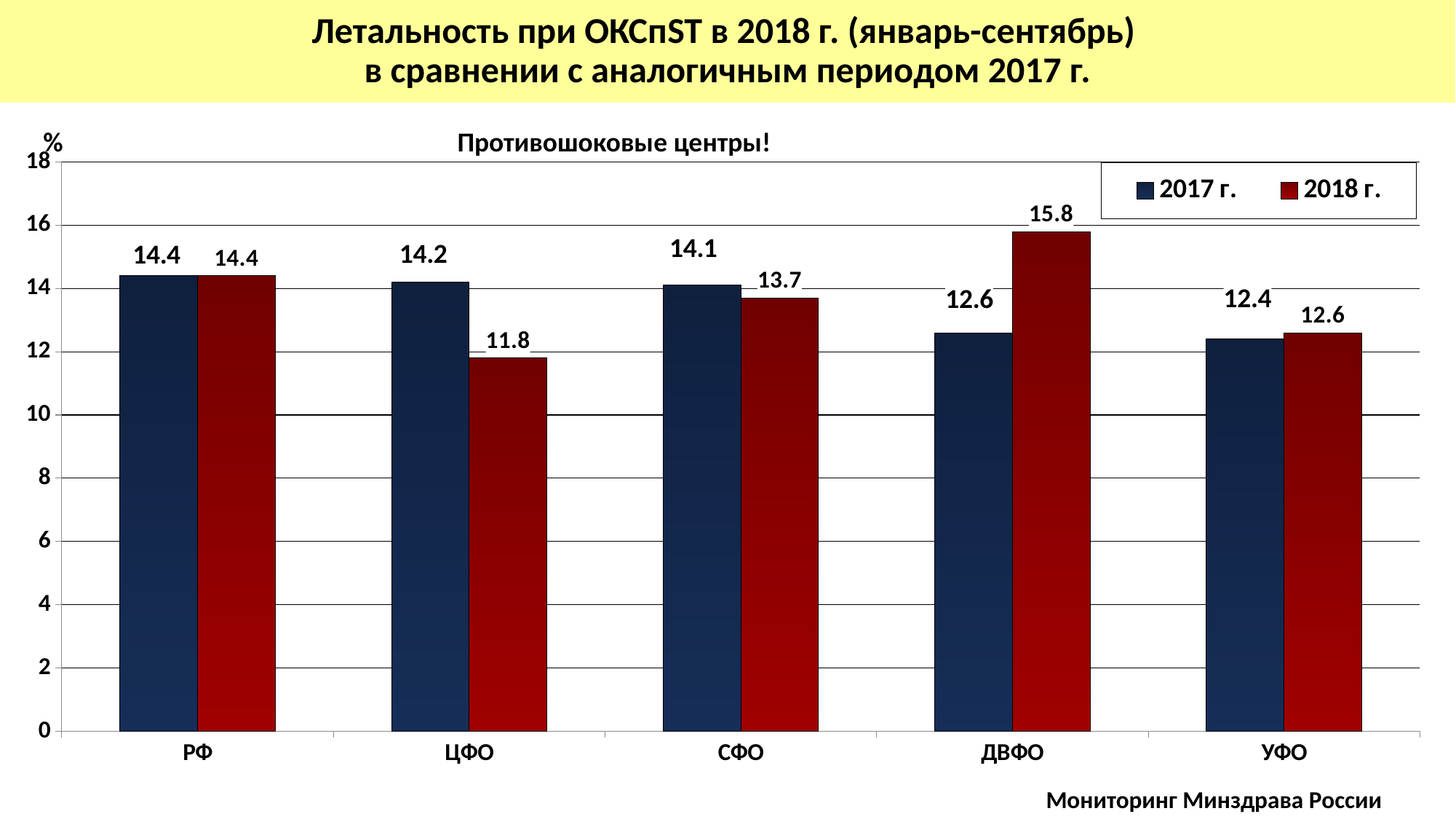
Which category has the lowest value in the 2018 г. series? ЦФО What is the difference between the 2018 г. and 2017 г. values for ДВФО? 3.2 Which is larger for СФО: the 2017 г. value or the 2018 г. value? 2017 г. How many series does the legend list? 2 How many categories are shown on the x axis? 5 What is the value for СФО in 2018 г.? 13.7 What is the value for ДВФО in 2017 г.? 12.6 What is the value for ЦФО in 2018 г.? 11.8 What is the difference between the 2017 г. and 2018 г. values for ЦФО? 2.4 Which category has the lowest value in the 2017 г. series? УФО What kind of chart is shown on the slide? Bar chart Which category has the highest value in the 2018 г. series? ДВФО